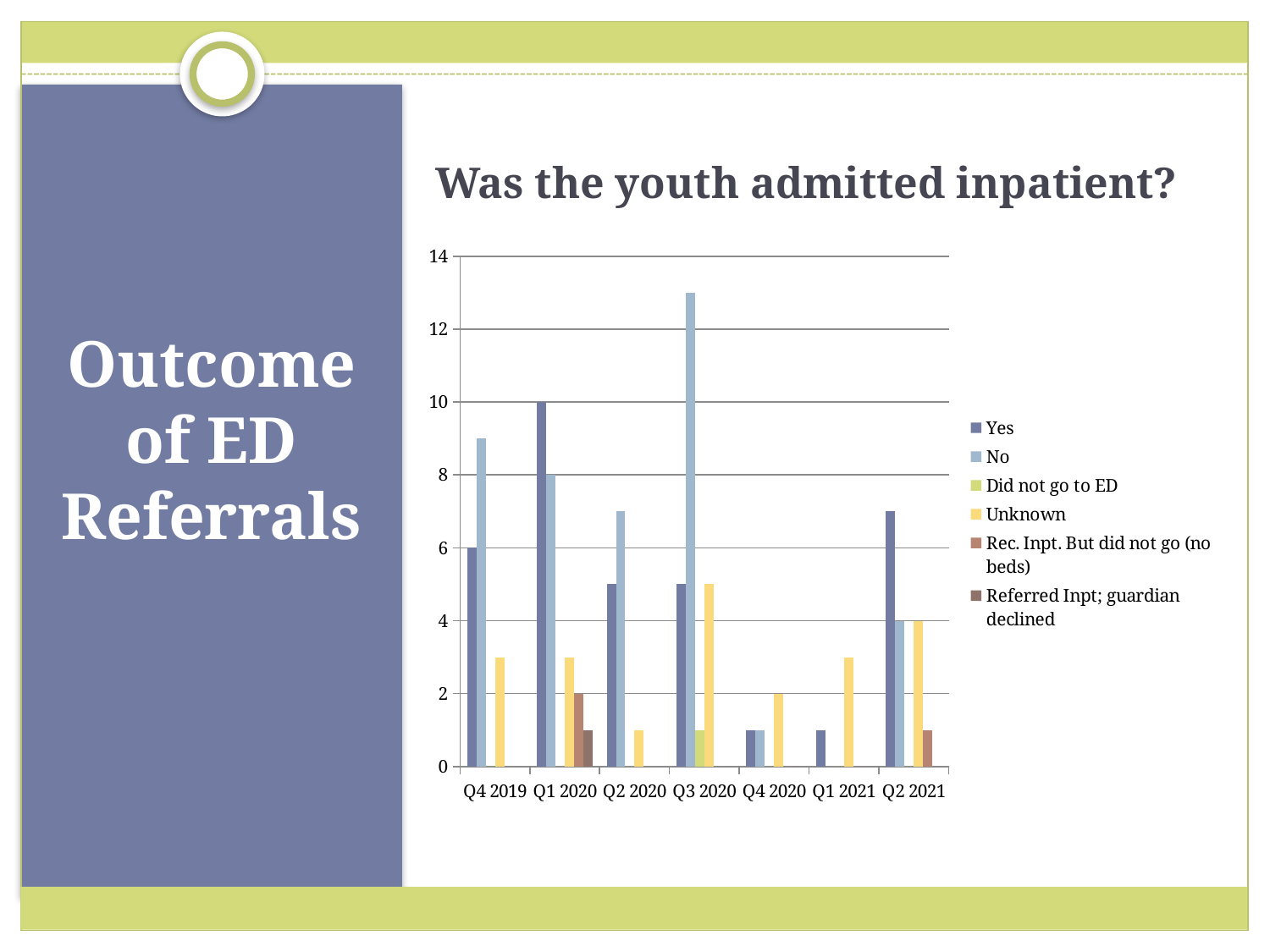
What is the value for 'Yes' in Q1 2020? 10 Is the value for 'No' in Q2 2020 greater or less than 6? greater How many quarters are shown on the x axis? 7 What is the value for 'Yes' in Q4 2019? 6 In which quarter is the 'No' bar the highest? Q3 2020 What is the value for 'Unknown' in Q4 2020? 2 Which is larger in Q4 2019, the 'Yes' bar or the 'No' bar? No What is the title of the chart? Was the youth admitted inpatient? What is the value for 'No' in Q1 2020? 8 How many series does the legend list? 6 What type of chart is shown on the slide? bar chart Is the value for 'No' in Q3 2020 greater or less than 12? greater